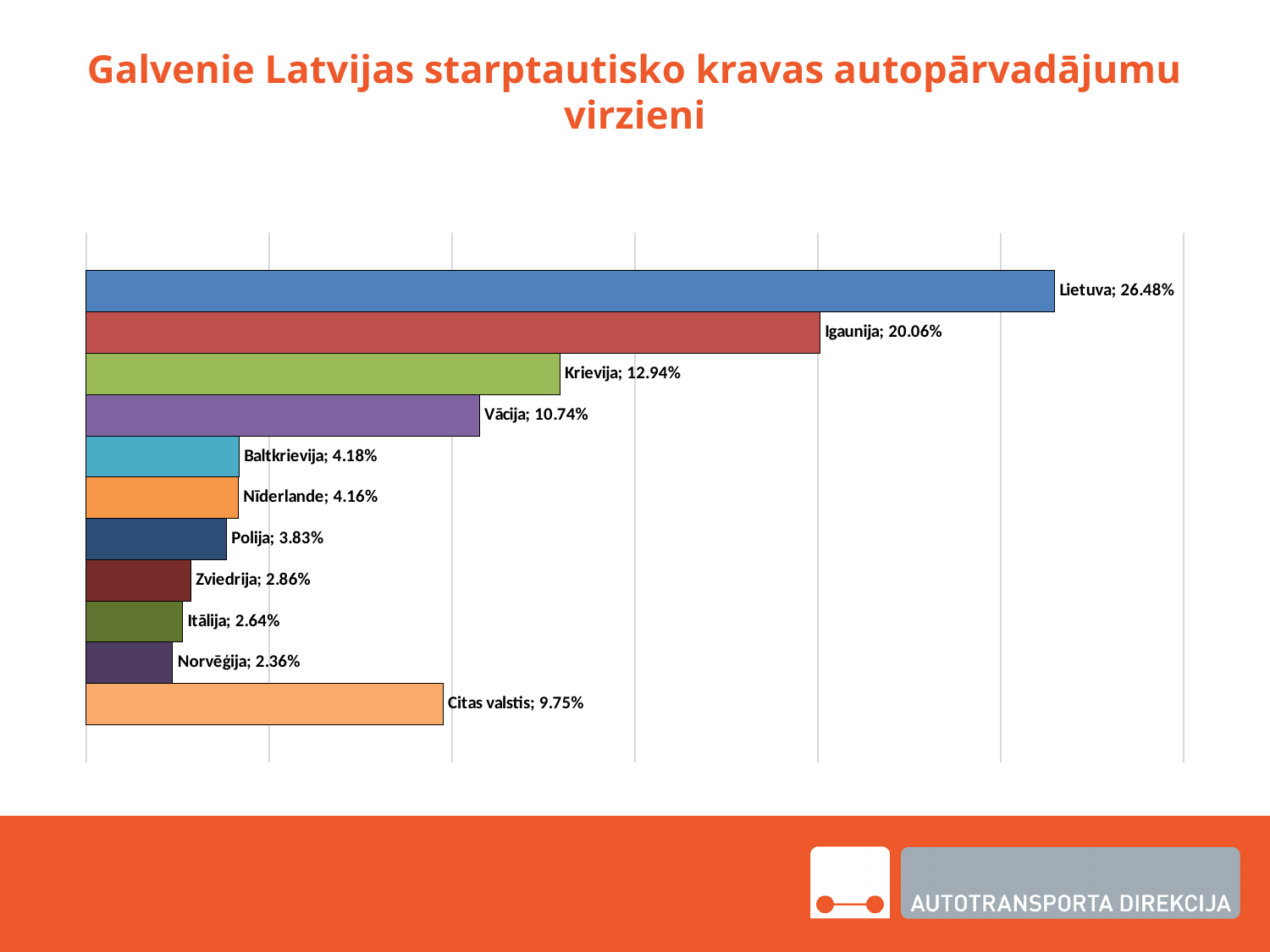
What is the value shown for Vācija? 10.74% What is the difference between the values for Lietuva and Igaunija? 6.42% What is the difference between the values for Krievija and Vācija? 2.20% What is the title of the slide? Galvenie Latvijas starptautisko kravas autopārvadājumu virzieni What is the value shown for Lietuva? 26.48% Which category has the highest value? Lietuva How many bars are shown in the chart? 11 Which category has the lowest value? Norvēģija What is the value shown for Zviedrija? 2.86% What kind of chart is shown on the slide? Bar chart Which is larger, the value for Krievija or the value for Citas valstis? Krievija What is the value shown for Citas valstis? 9.75%